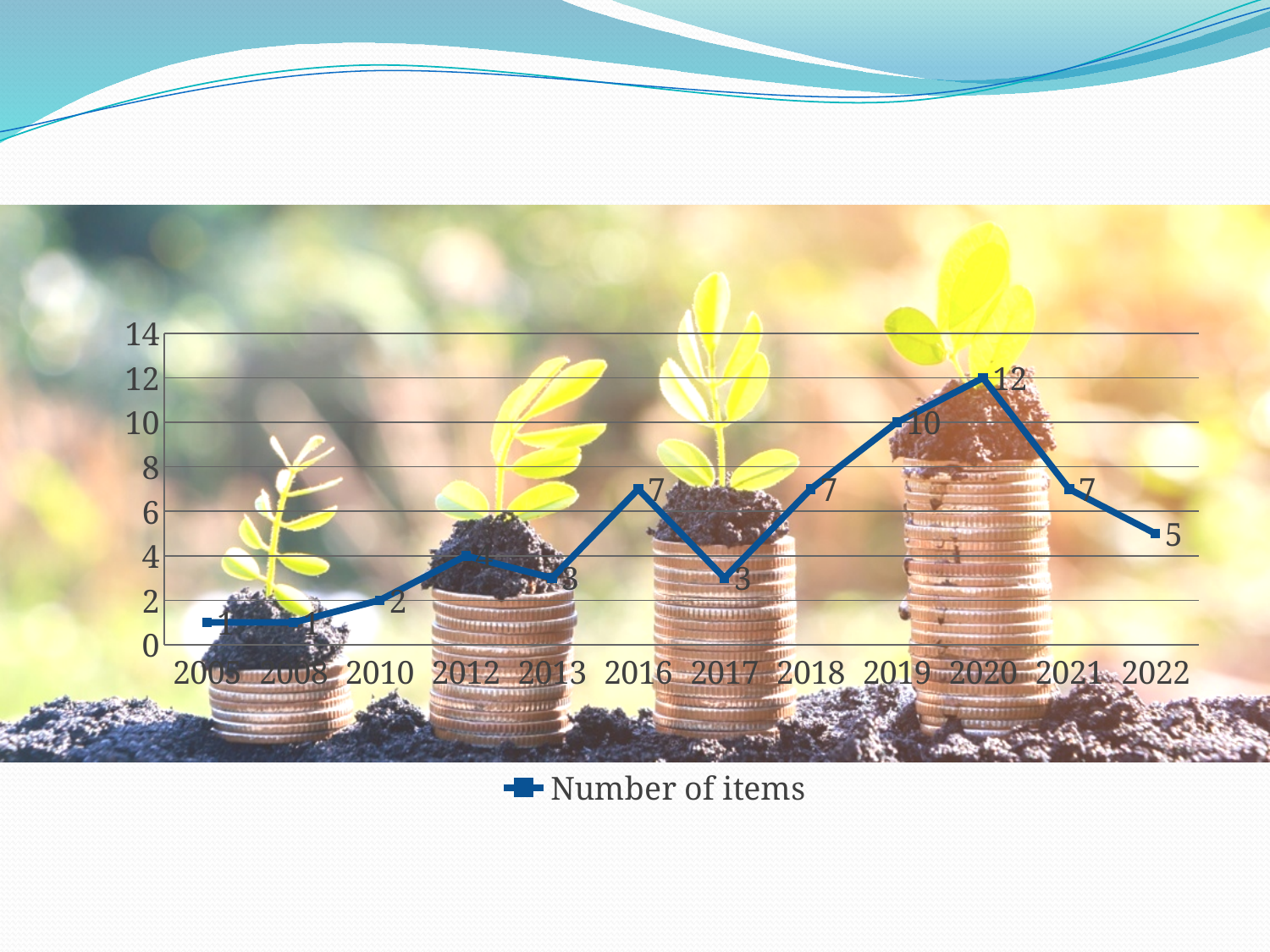
Which year has the highest number of items? 2020 What is the number of items in 2020? 12 What type of chart is shown on the slide? line chart Is the number of items in 2019 greater or less than 8? greater How many series does the legend list? 1 What is the number of items in 2022? 5 What is the difference in the number of items between 2020 and 2021? 5 How many years are plotted on the x axis? 12 What is the number of items in 2019? 10 Which year has more items, 2016 or 2017? 2016 What is the name of the series shown in the legend? Number of items What is the number of items in 2017? 3